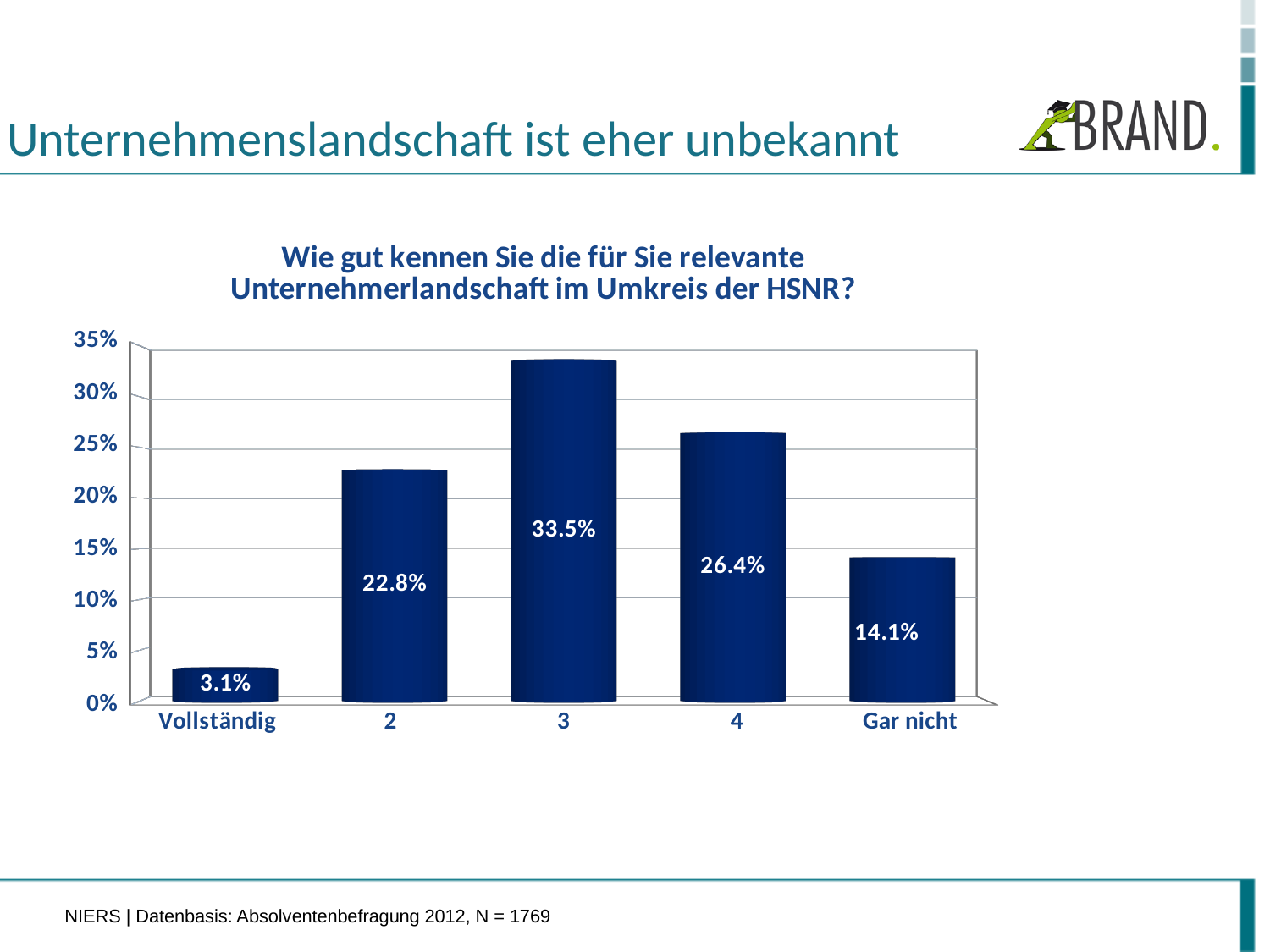
What kind of chart is shown on the slide? bar chart Which category has the lowest value? Vollständig What is the title of the chart? Wie gut kennen Sie die für Sie relevante Unternehmerlandschaft im Umkreis der HSNR? What is the difference between the values for "3" and "4"? 7.1% What is the difference between the values for "2" and "Vollständig"? 19.7% Is the value for "Gar nicht" greater or less than 15%? less How many categories are shown on the x axis? 5 Which is larger, the value for "2" or the value for "4"? 4 What is the value for the category "3"? 33.5% What is the value for "Gar nicht"? 14.1% What is the value for "Vollständig"? 3.1% Which category has the highest value? 3